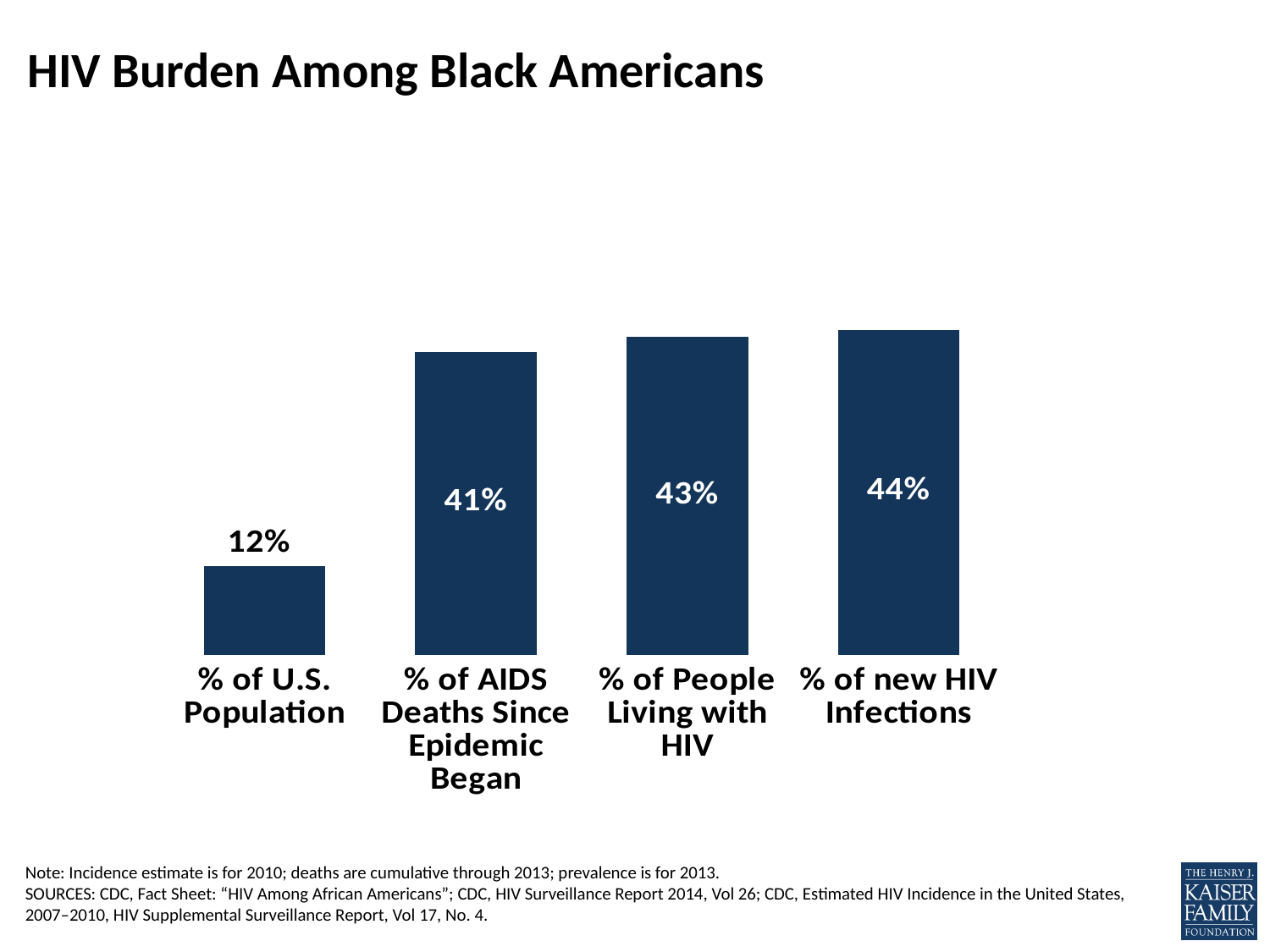
What is the value for % of new HIV Infections? 44% How many categories are shown in the chart? 4 What is the value for % of AIDS Deaths Since Epidemic Began? 41% What is the difference between % of new HIV Infections and % of U.S. Population? 32% Which category has the highest value? % of new HIV Infections What is the title of the chart? HIV Burden Among Black Americans What kind of chart is shown on the slide? Bar chart Which is larger, % of AIDS Deaths Since Epidemic Began or % of U.S. Population? % of AIDS Deaths Since Epidemic Began What is the value for % of U.S. Population? 12% Which category has the lowest value? % of U.S. Population What is the difference between % of People Living with HIV and % of AIDS Deaths Since Epidemic Began? 2% What is the value for % of People Living with HIV? 43%